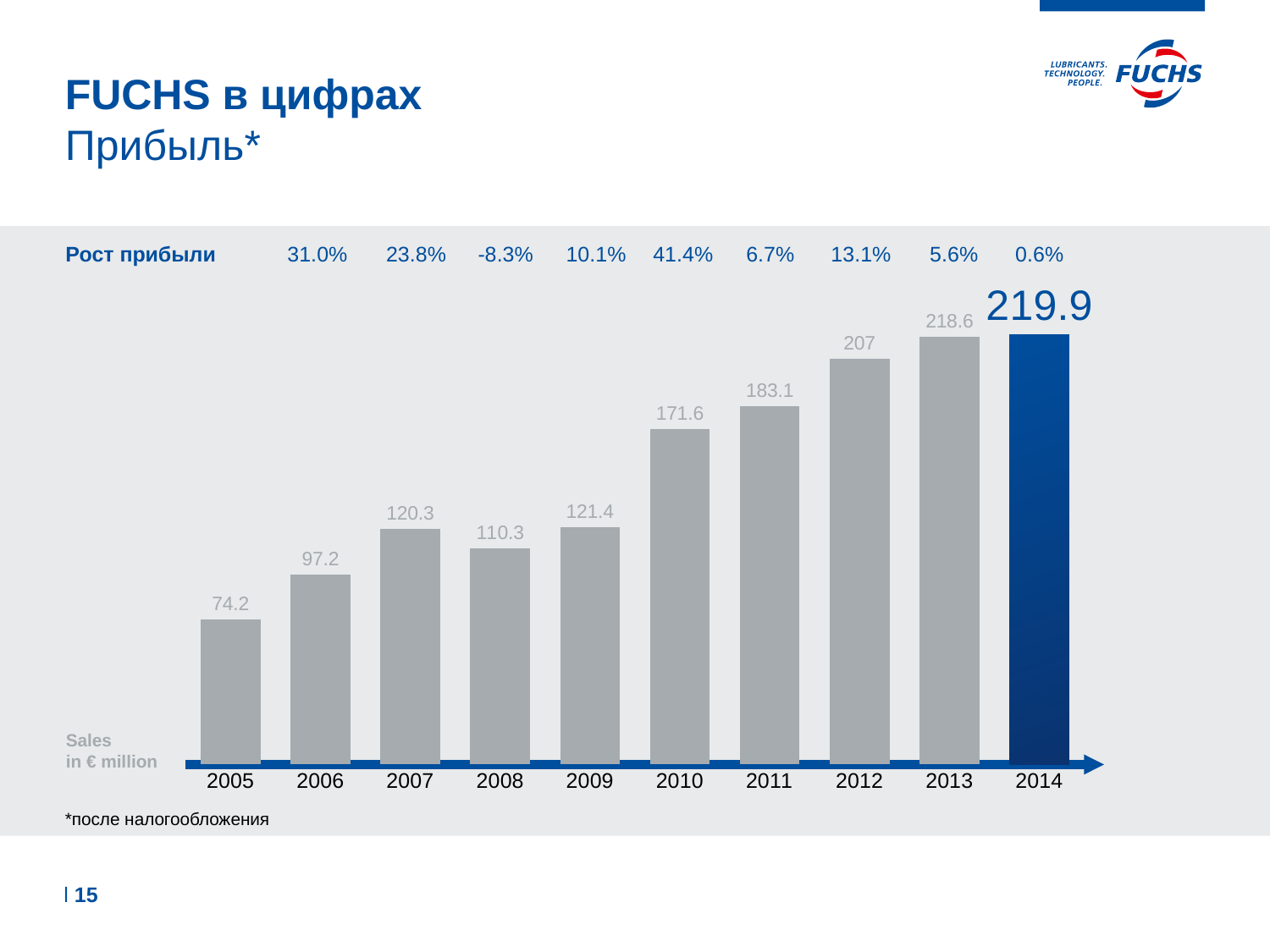
What kind of chart is shown on the slide? bar chart What profit growth percentage is shown above the chart for 2010? 41.4% What is the profit value shown for 2014? 219.9 What is the difference between the profit values for 2012 and 2011? 23.9 Which year has the larger profit value, 2008 or 2009? 2009 Which year has the highest profit value? 2014 Between 2007 and 2008, did the profit value rise or fall? fall How many years are shown on the x axis of the chart? 10 Which year has the lowest profit value? 2005 Which bar in the chart is coloured dark blue rather than grey? 2014 What is the profit value shown for 2010? 171.6 What is the profit value shown for 2005? 74.2